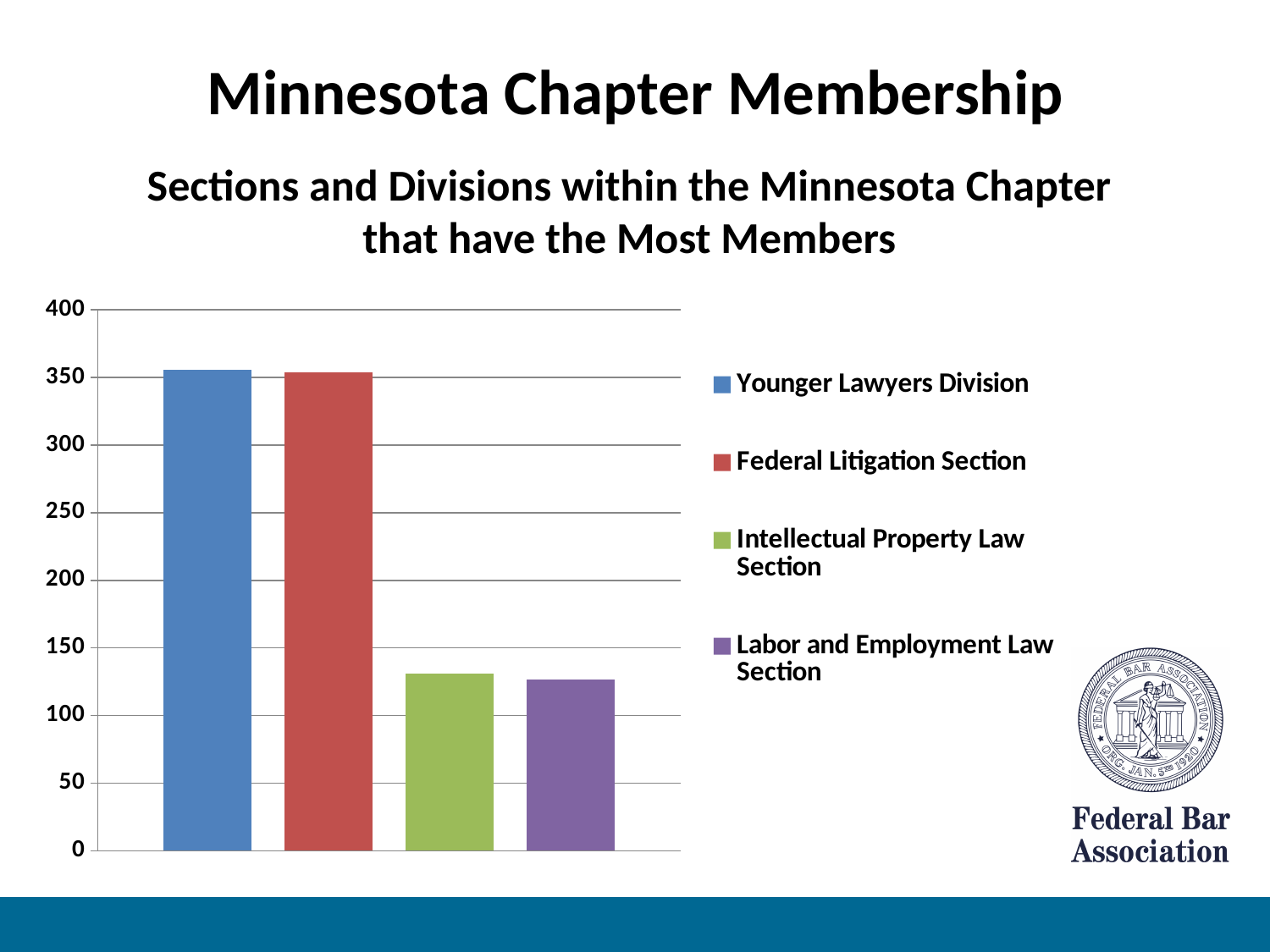
Which is larger, the value for Younger Lawyers Division or the value for Intellectual Property Law Section? Younger Lawyers Division Is the value for Younger Lawyers Division greater or less than 300? greater Is the value for Intellectual Property Law Section greater or less than 150? less Which is larger, the value for Labor and Employment Law Section or the value for Federal Litigation Section? Federal Litigation Section Is the value for Federal Litigation Section greater or less than 400? less How many series does the legend list? 4 How many bars are plotted in the chart? 4 What kind of chart is shown on the slide? bar chart What is the title of the chart? Sections and Divisions within the Minnesota Chapter that have the Most Members What colour is the bar for Federal Litigation Section? red